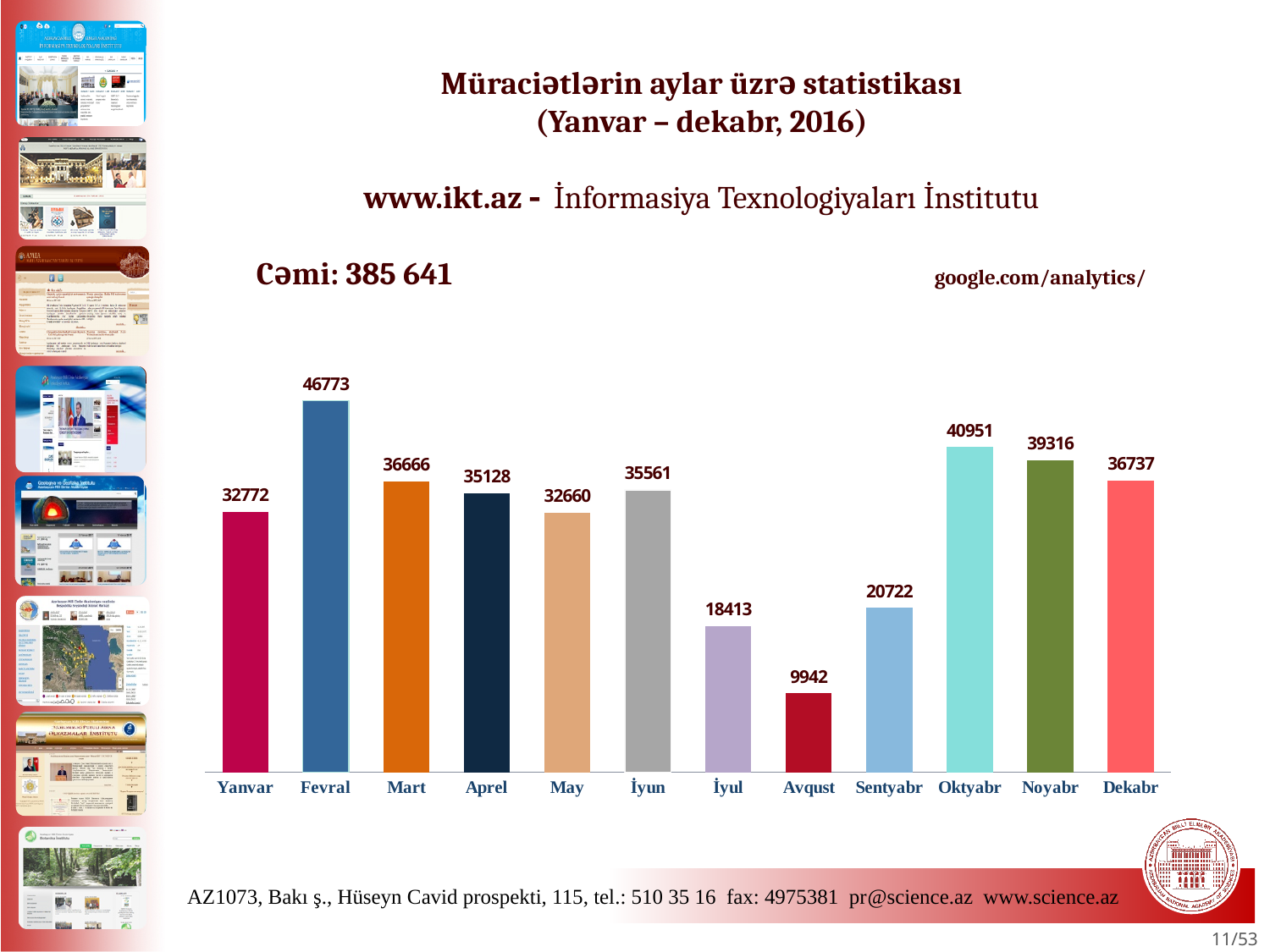
Do the values rise or fall from İyun to Avqust? Fall What is the value for Sentyabr? 20722 What is the difference between the values for Oktyabr and Noyabr? 1635 Which is larger, the value for İyul or the value for Sentyabr? Sentyabr How many months are shown on the chart? 12 What is the value for Avqust? 9942 Which month has the lowest value? Avqust Which month has the highest value? Fevral What is the difference between the values for Fevral and Avqust? 36831 What kind of chart is shown on the slide? Bar chart What is the value for Oktyabr? 40951 What is the value for Fevral? 46773